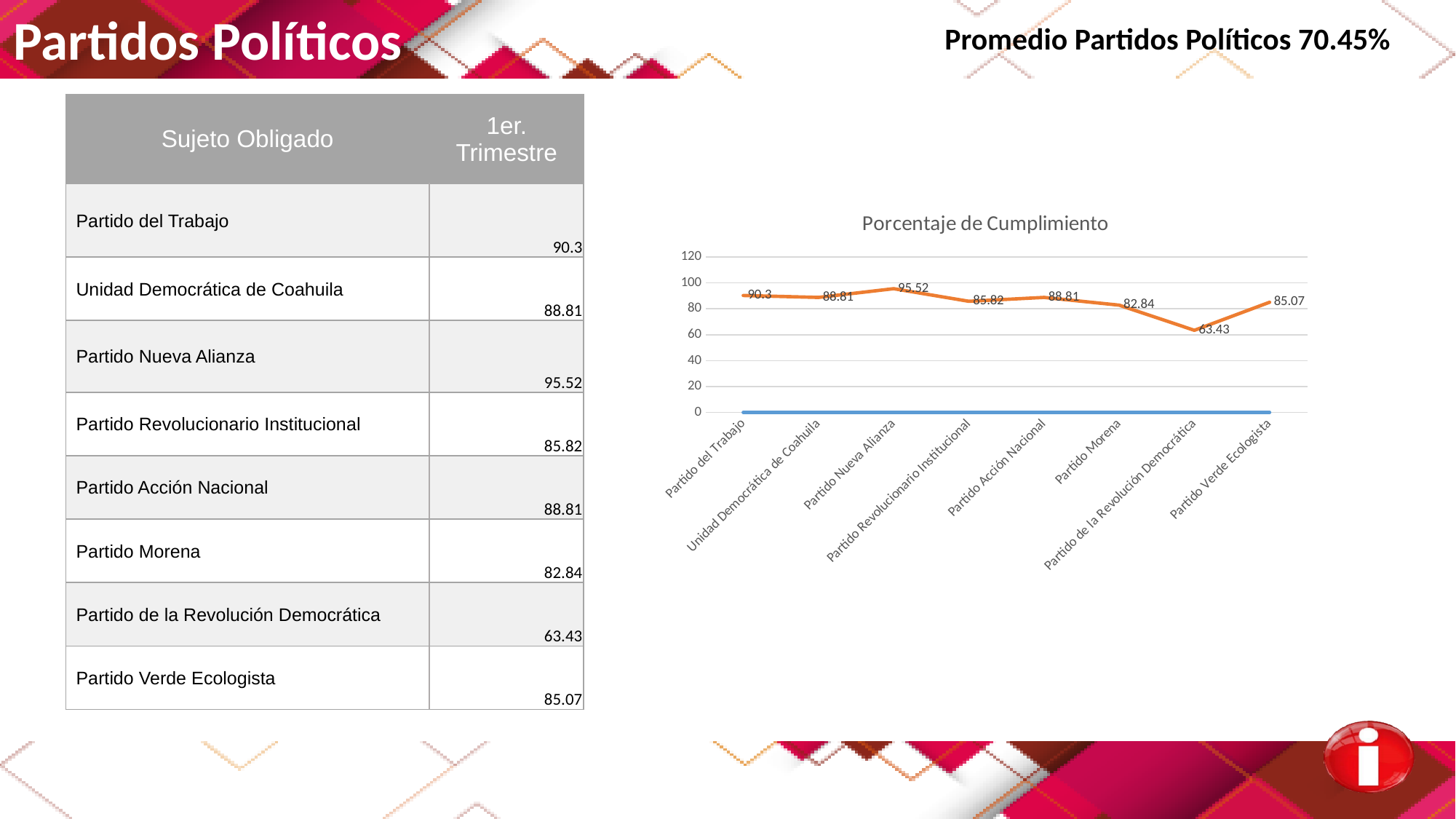
What is the difference between the values for Partido Nueva Alianza and Partido de la Revolución Democrática? 32.09 Which category has the lowest value in the chart? Partido de la Revolución Democrática What is the value for Partido Verde Ecologista in the chart? 85.07 Which category has the highest value in the chart? Partido Nueva Alianza Is the value for Partido de la Revolución Democrática greater or less than 80? less What kind of chart is shown on the slide? line chart How many categories are plotted along the x axis of the chart? 8 What is the value for Partido de la Revolución Democrática in the chart? 63.43 What is the difference between the values for Partido del Trabajo and Partido Revolucionario Institucional? 4.48 What is the value for Partido Nueva Alianza in the chart? 95.52 What is the title of the chart? Porcentaje de Cumplimiento Which is larger, the value for Partido del Trabajo or the value for Partido Morena? Partido del Trabajo